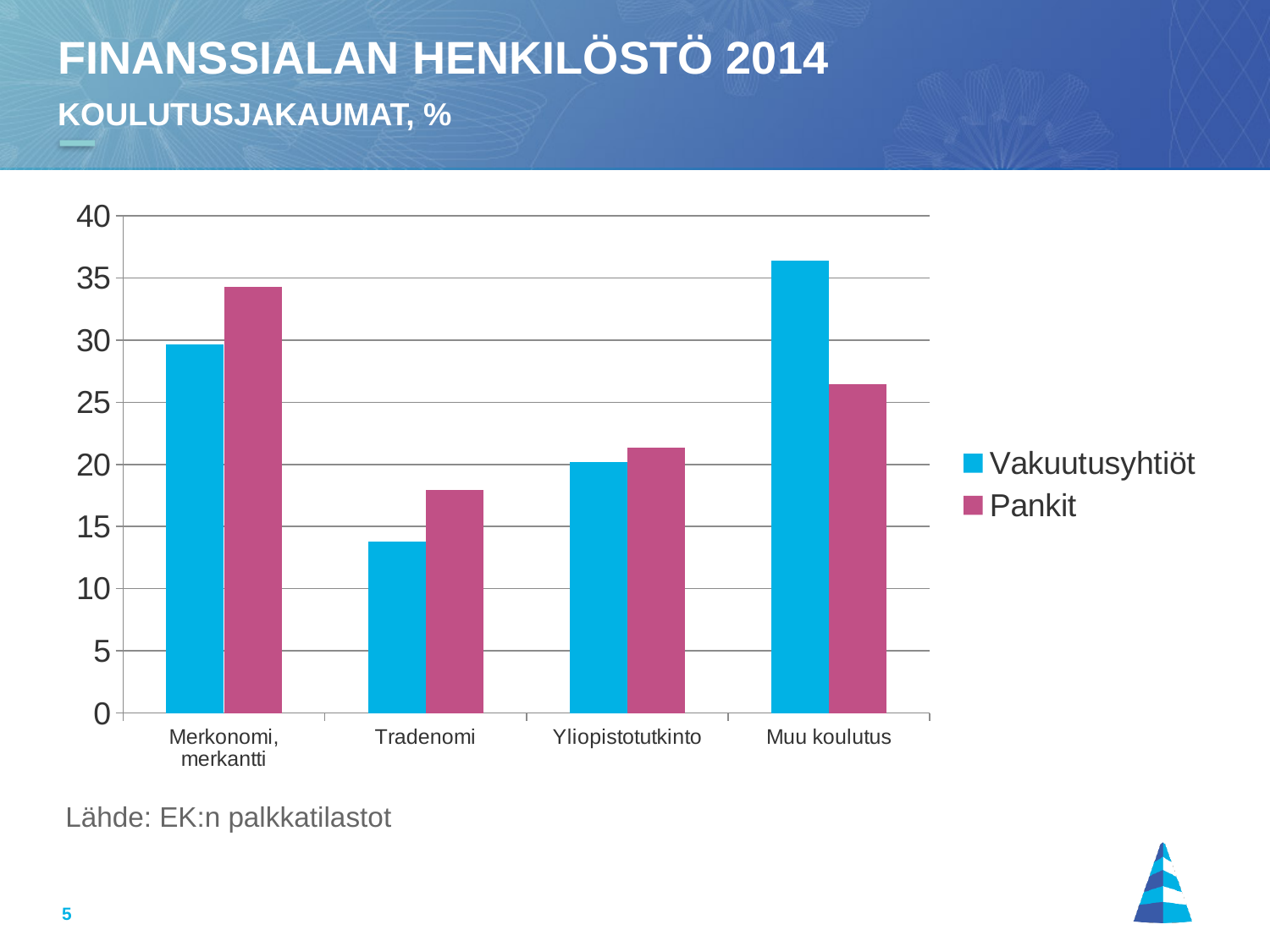
How many series does the legend list? 2 Which category has the lowest value for Vakuutusyhtiöt? Tradenomi Which category has the highest value for Pankit? Merkonomi, merkantti Which category has the lowest value for Pankit? Tradenomi Which category has the highest value for Vakuutusyhtiöt? Muu koulutus Is the value for Vakuutusyhtiöt in Tradenomi greater or less than 15? less For Muu koulutus, which series has the larger value, Vakuutusyhtiöt or Pankit? Vakuutusyhtiöt Is the value for Vakuutusyhtiöt in Muu koulutus greater or less than 35? greater What kind of chart is shown on the slide? bar chart What source is cited below the chart? EK:n palkkatilastot How many education categories are shown on the x axis? 4 For Merkonomi, merkantti, which series has the larger value, Vakuutusyhtiöt or Pankit? Pankit